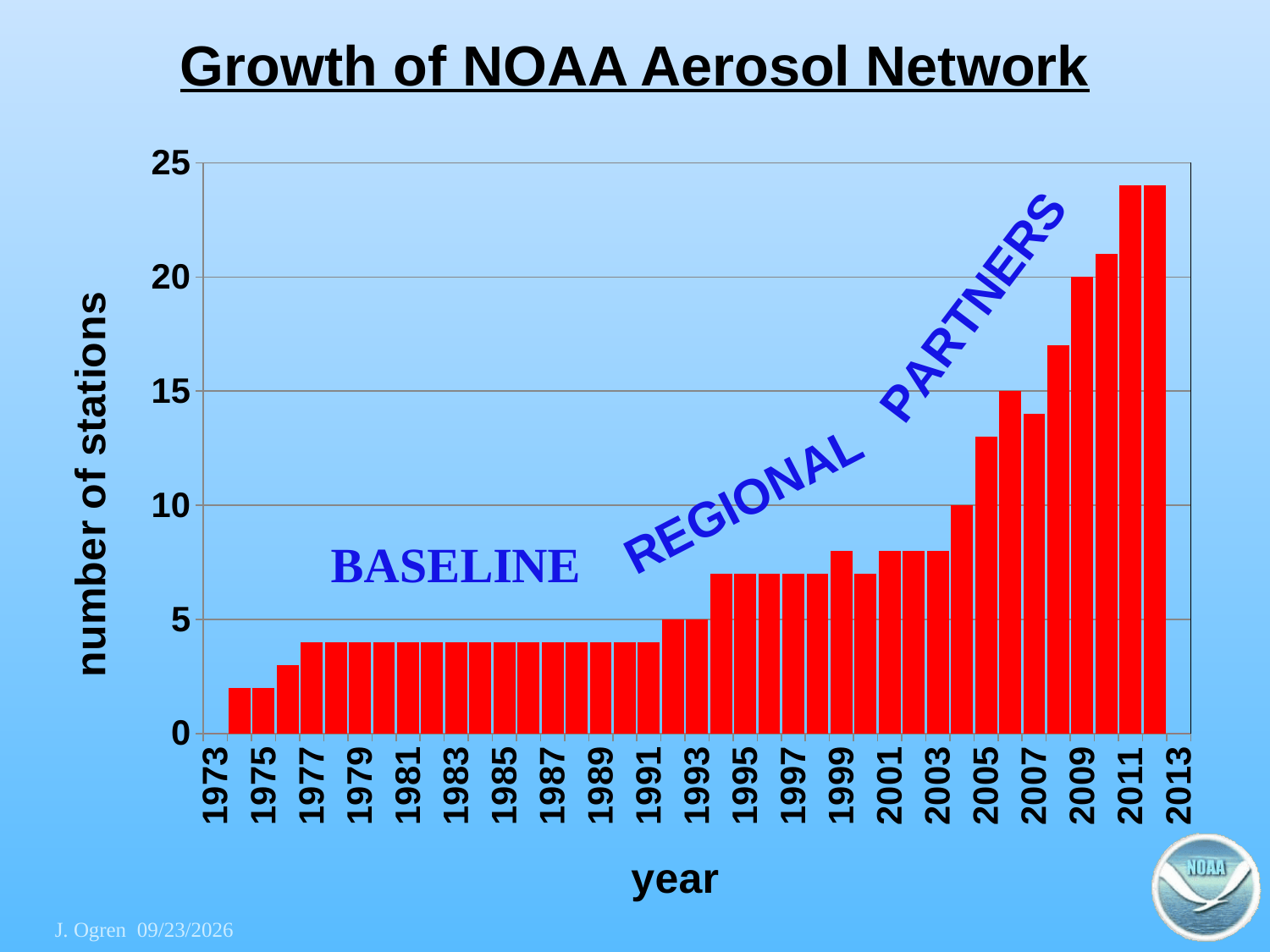
Is the number of stations in 2001 greater or less than 10? less Is the number of stations in 2008 greater or less than 15? greater What is the number of stations in 2009? 20 Is the number of stations in 1985 greater or less than 5? less What is the number of stations in 2004? 10 What is the number of stations in 1993? 5 What is the title of the chart? Growth of NOAA Aerosol Network What kind of chart is shown on the slide? bar chart What is the number of stations in 2006? 15 Which year has more stations, 2005 or 2009? 2009 Overall, does the number of stations rise or fall from 1973 to 2012? rise